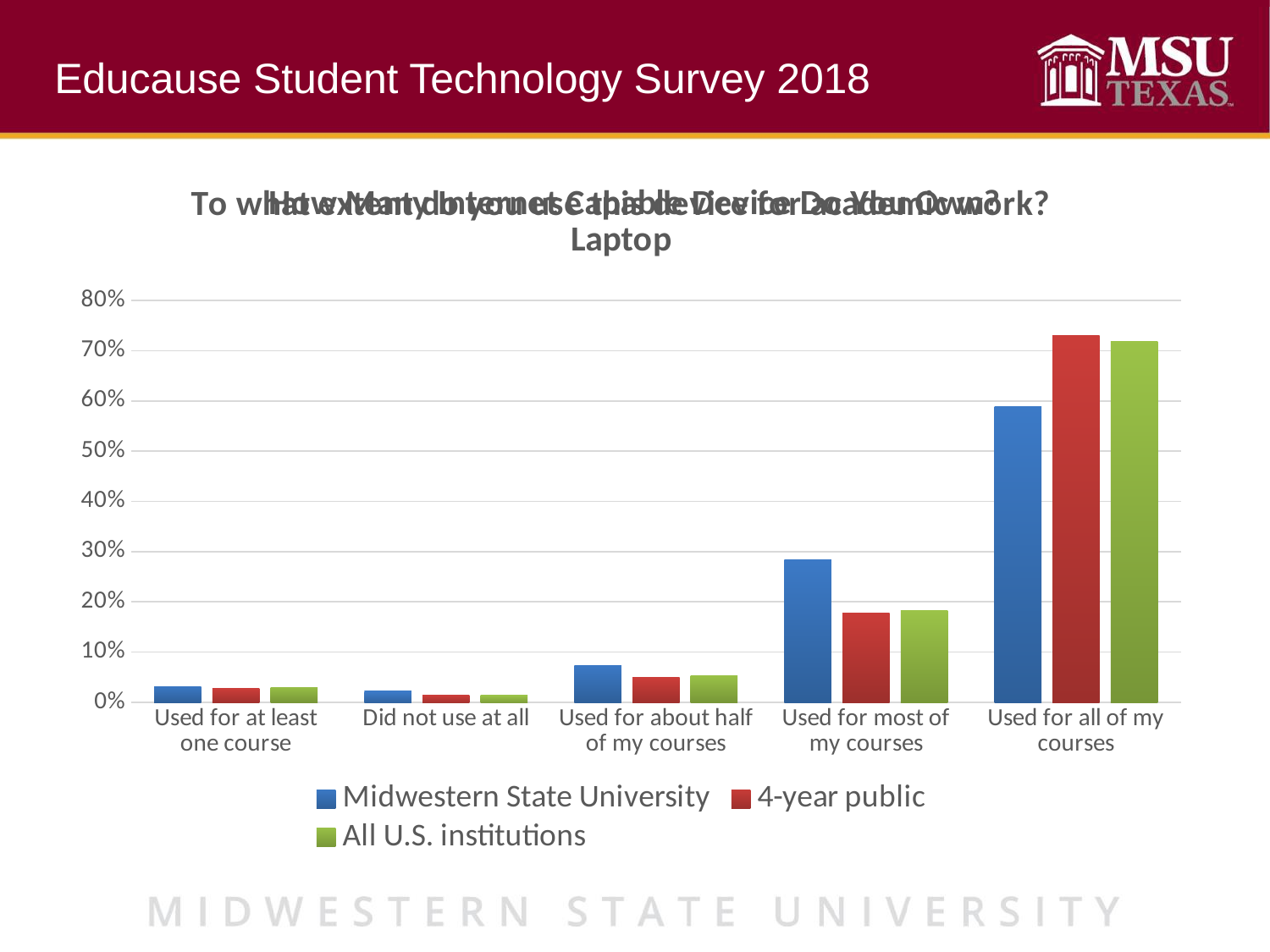
For 'Used for all of my courses', which is larger: Midwestern State University or 4-year public? 4-year public How many series does the chart's legend list? 3 What kind of chart is shown on the slide? bar chart Is the Midwestern State University value for 'Used for all of my courses' greater or less than 50%? greater Is the 4-year public value for 'Used for all of my courses' greater or less than 60%? greater For 'Used for most of my courses', which is larger: Midwestern State University or All U.S. institutions? Midwestern State University Is the All U.S. institutions value for 'Used for about half of my courses' greater or less than 10%? less How many categories are shown on the x axis of the chart? 5 For Midwestern State University, which category has the highest value? Used for all of my courses What colour represents Midwestern State University in the chart? blue For 4-year public, which category has the lowest value? Did not use at all